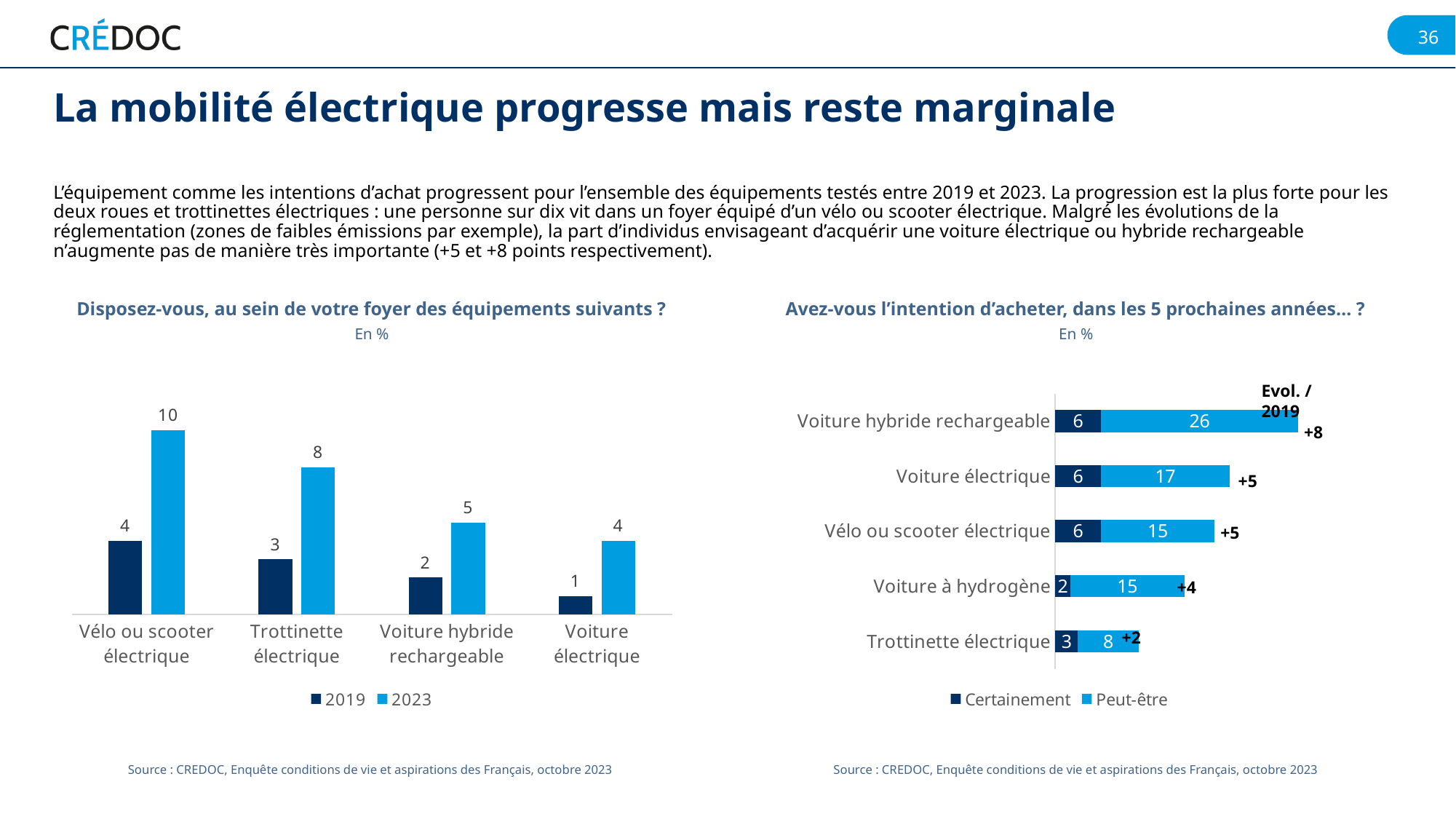
In the right chart 'Avez-vous l'intention d'acheter, dans les 5 prochaines années… ?', which is larger: the 'Peut-être' value for Voiture électrique or for Trottinette électrique? Voiture électrique In the left chart 'Disposez-vous, au sein de votre foyer des équipements suivants ?', what is the 2019 value for Voiture électrique? 1 In the left chart 'Disposez-vous, au sein de votre foyer des équipements suivants ?', what is the 2023 value for Vélo ou scooter électrique? 10 In the left chart 'Disposez-vous, au sein de votre foyer des équipements suivants ?', which category has the lowest 2019 value? Voiture électrique In the left chart 'Disposez-vous, au sein de votre foyer des équipements suivants ?', which category has the highest 2023 value? Vélo ou scooter électrique In the right chart 'Avez-vous l'intention d'acheter, dans les 5 prochaines années… ?', what is the 'Evol. / 2019' value shown for Voiture à hydrogène? +4 In the left chart 'Disposez-vous, au sein de votre foyer des équipements suivants ?', what is the difference between the 2023 and 2019 values for Trottinette électrique? 5 In the left chart 'Disposez-vous, au sein de votre foyer des équipements suivants ?', how many categories are shown on the x axis? 4 In the left chart 'Disposez-vous, au sein de votre foyer des équipements suivants ?', how many series does the legend list? 2 In the right chart 'Avez-vous l'intention d'acheter, dans les 5 prochaines années… ?', what is the 'Peut-être' value for Voiture hybride rechargeable? 26 What kind of chart is the right chart 'Avez-vous l'intention d'acheter, dans les 5 prochaines années… ?'? Stacked bar chart In the right chart 'Avez-vous l'intention d'acheter, dans les 5 prochaines années… ?', what is the total of the stacked bar for Voiture électrique? 23